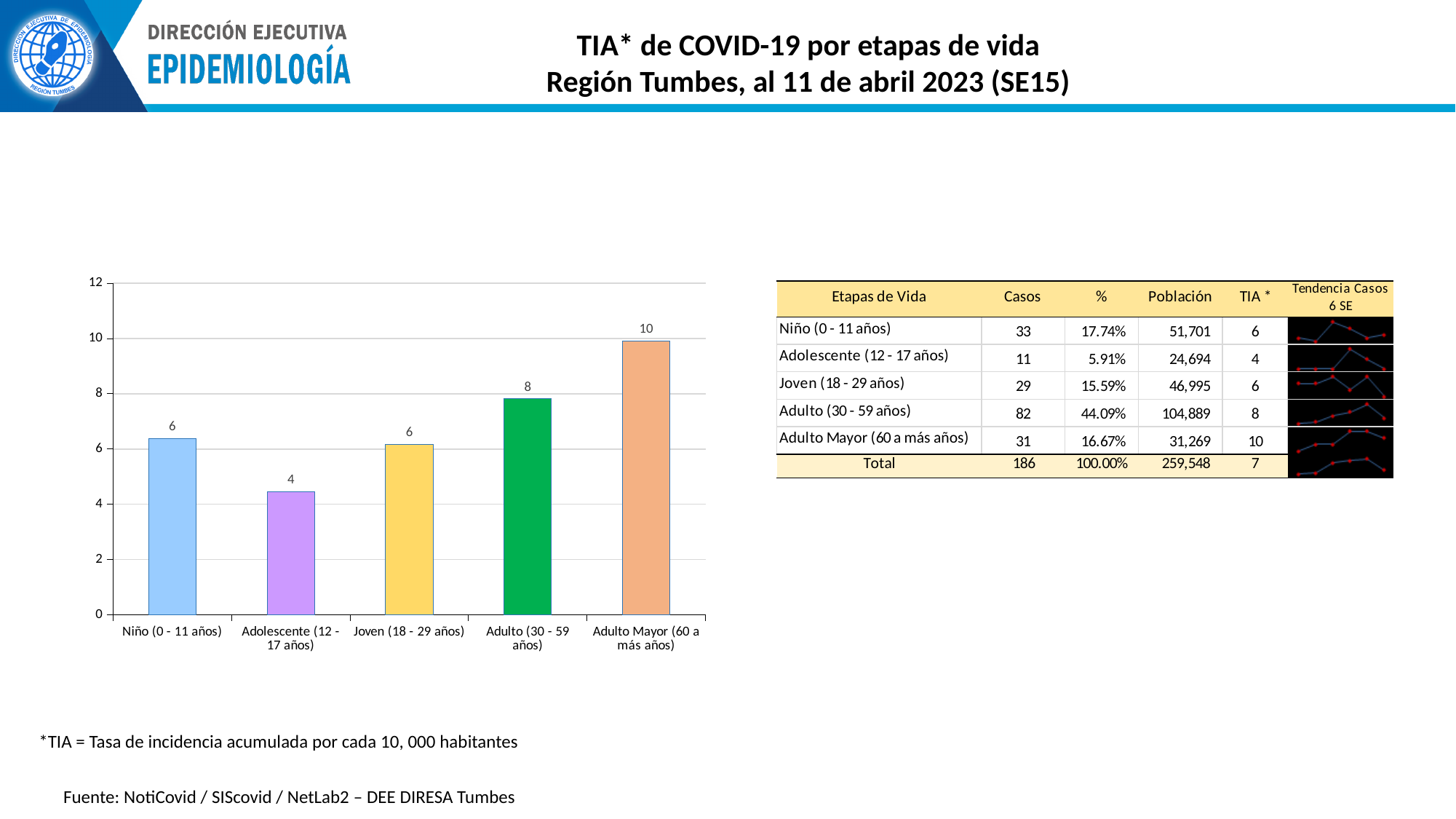
Which category has the lowest value in the bar chart? Adolescente (12 - 17 años) Which category has the highest value in the bar chart? Adulto Mayor (60 a más años) What colour is the bar for Adulto (30 - 59 años)? green What is the value shown for Adulto (30 - 59 años) in the bar chart? 8 What is the value shown for Adolescente (12 - 17 años) in the bar chart? 4 Is the value for Adolescente (12 - 17 años) greater or less than 6? less What is the value shown for Niño (0 - 11 años) in the bar chart? 6 What is the difference between the values for Adulto Mayor (60 a más años) and Adolescente (12 - 17 años)? 6 What kind of chart is shown on the slide? bar chart Which is larger, the value for Adulto (30 - 59 años) or the value for Joven (18 - 29 años)? Adulto (30 - 59 años) How many categories are shown in the bar chart? 5 What is the value shown for Adulto Mayor (60 a más años) in the bar chart? 10